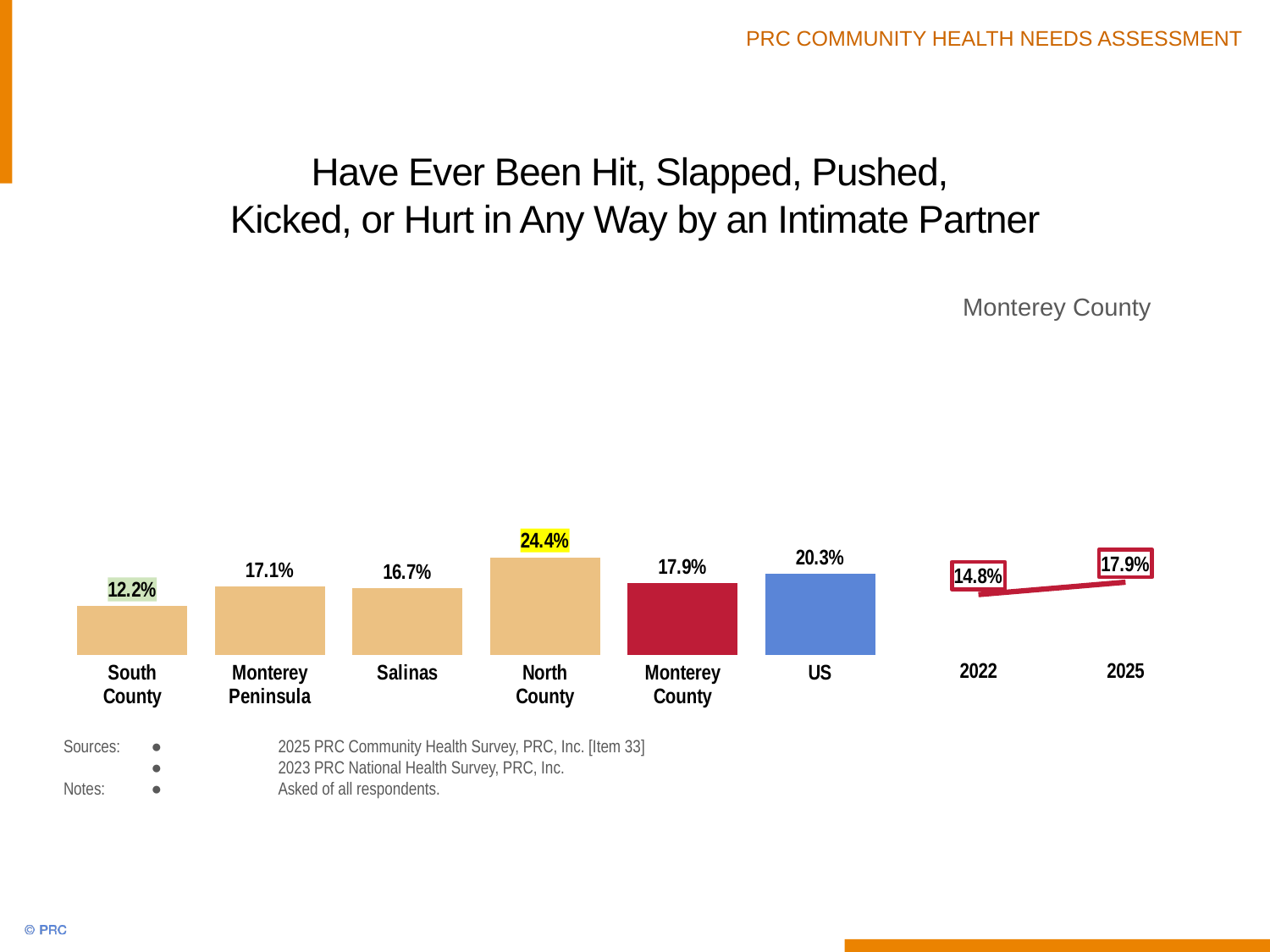
In the bar chart, what is the value for North County? 24.4% How many areas are shown in the bar chart? 6 In the bar chart, what is the value for the US? 20.3% In the bar chart, which area has the lowest value? South County In the line chart on the right, what is the value for 2022? 14.8% In the line chart on the right, what is the difference between the 2025 value and the 2022 value? 3.1 percentage points What kind of chart is the chart on the left? bar chart In the bar chart, which area has the highest value? North County In the bar chart, what is the value for South County? 12.2% In the bar chart, what is the difference between the US value and the Monterey County value? 2.4 percentage points In the line chart on the right, does the value rise or fall from 2022 to 2025? rise In the bar chart, which is larger, the value for Monterey Peninsula or the value for Salinas? Monterey Peninsula